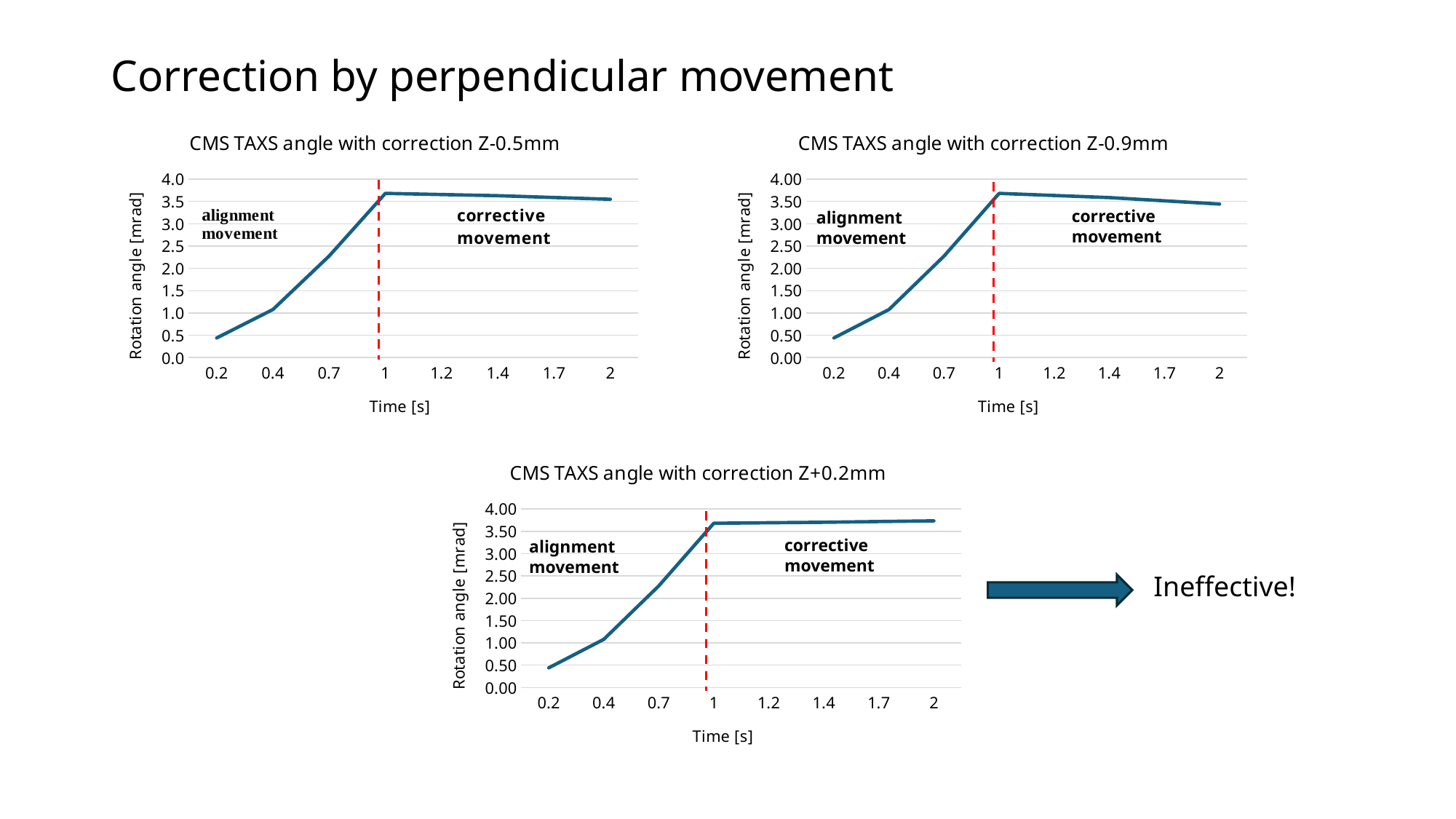
In the 'CMS TAXS angle with correction Z-0.5mm' chart, which time has the larger rotation angle, 0.2 s or 1 s? 1 s In the 'CMS TAXS angle with correction Z-0.5mm' chart, is the rotation angle at 0.7 s greater or less than 2.0 mrad? greater In the 'CMS TAXS angle with correction Z-0.9mm' chart, does the rotation angle rise or fall between 0.2 s and 1 s? rise In the 'CMS TAXS angle with correction Z-0.9mm' chart, is the rotation angle at 1 s greater or less than 3.00 mrad? greater What is the y-axis label of the 'CMS TAXS angle with correction Z+0.2mm' chart? Rotation angle [mrad] In the 'CMS TAXS angle with correction Z-0.5mm' chart, is the rotation angle at 0.2 s greater or less than 1.0 mrad? less In the 'CMS TAXS angle with correction Z-0.9mm' chart, does the rotation angle rise or fall between 1 s and 2 s? fall How many time points are marked on the x axis of the 'CMS TAXS angle with correction Z-0.9mm' chart? 8 What kind of chart is 'CMS TAXS angle with correction Z-0.5mm'? line chart What is the title of the chart at the bottom of the slide? CMS TAXS angle with correction Z+0.2mm In the 'CMS TAXS angle with correction Z+0.2mm' chart, at which time is the rotation angle lowest? 0.2